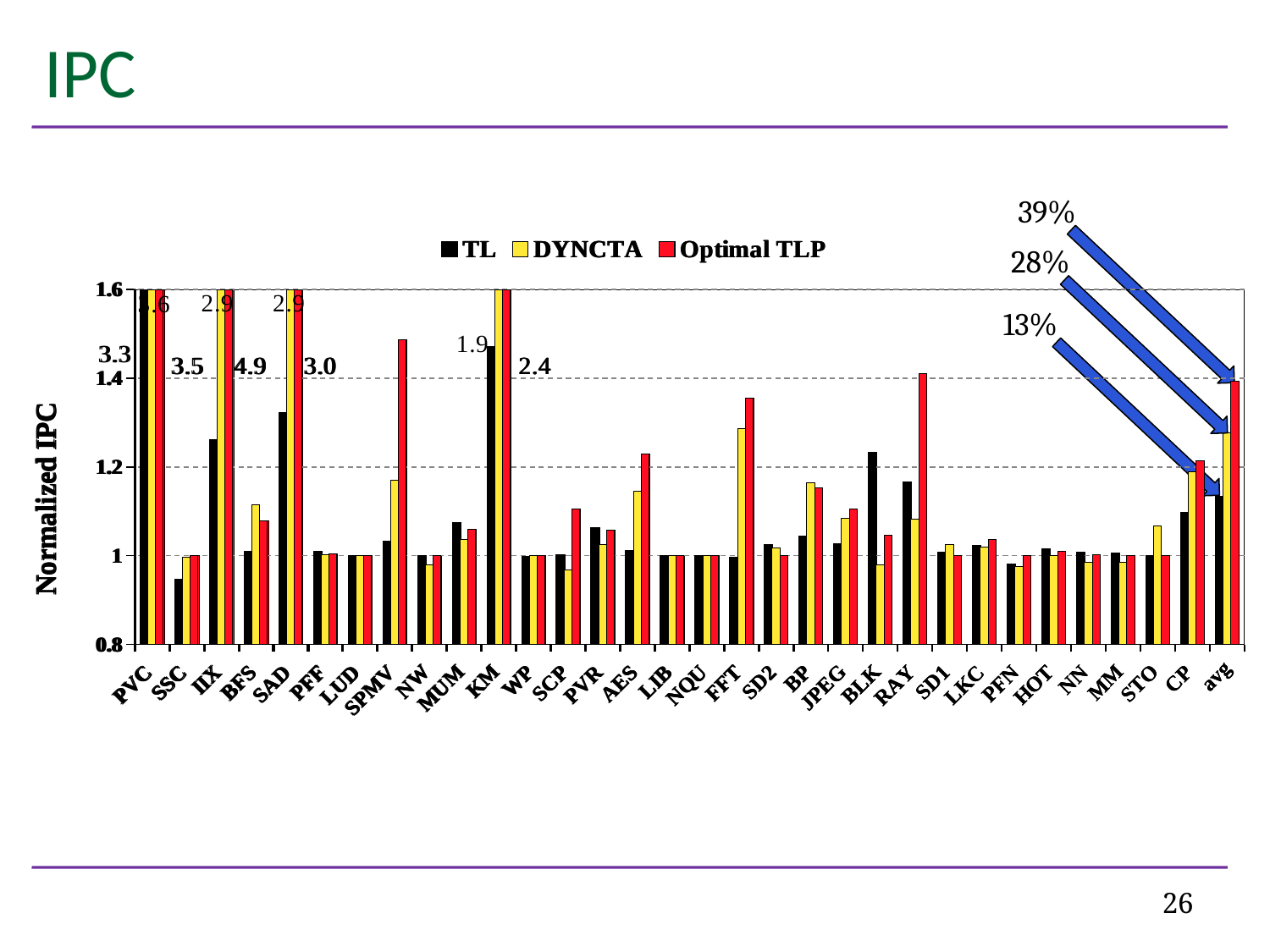
How many categories are shown along the x axis? 32 How many series does the legend list? 3 For BLK, which is larger: the TL value or the DYNCTA value? TL Is the DYNCTA value for BLK greater or less than 1? less What is the label of the y axis? Normalized IPC Is the Optimal TLP value for SPMV greater or less than 1.4? greater For FFT, which is larger: the TL value or the DYNCTA value? DYNCTA Is the Optimal TLP value for FFT greater or less than 1.2? greater What kind of chart is shown on the slide? bar chart For SPMV, which is larger: the TL value or the Optimal TLP value? Optimal TLP What are the three series named in the legend? TL, DYNCTA, Optimal TLP